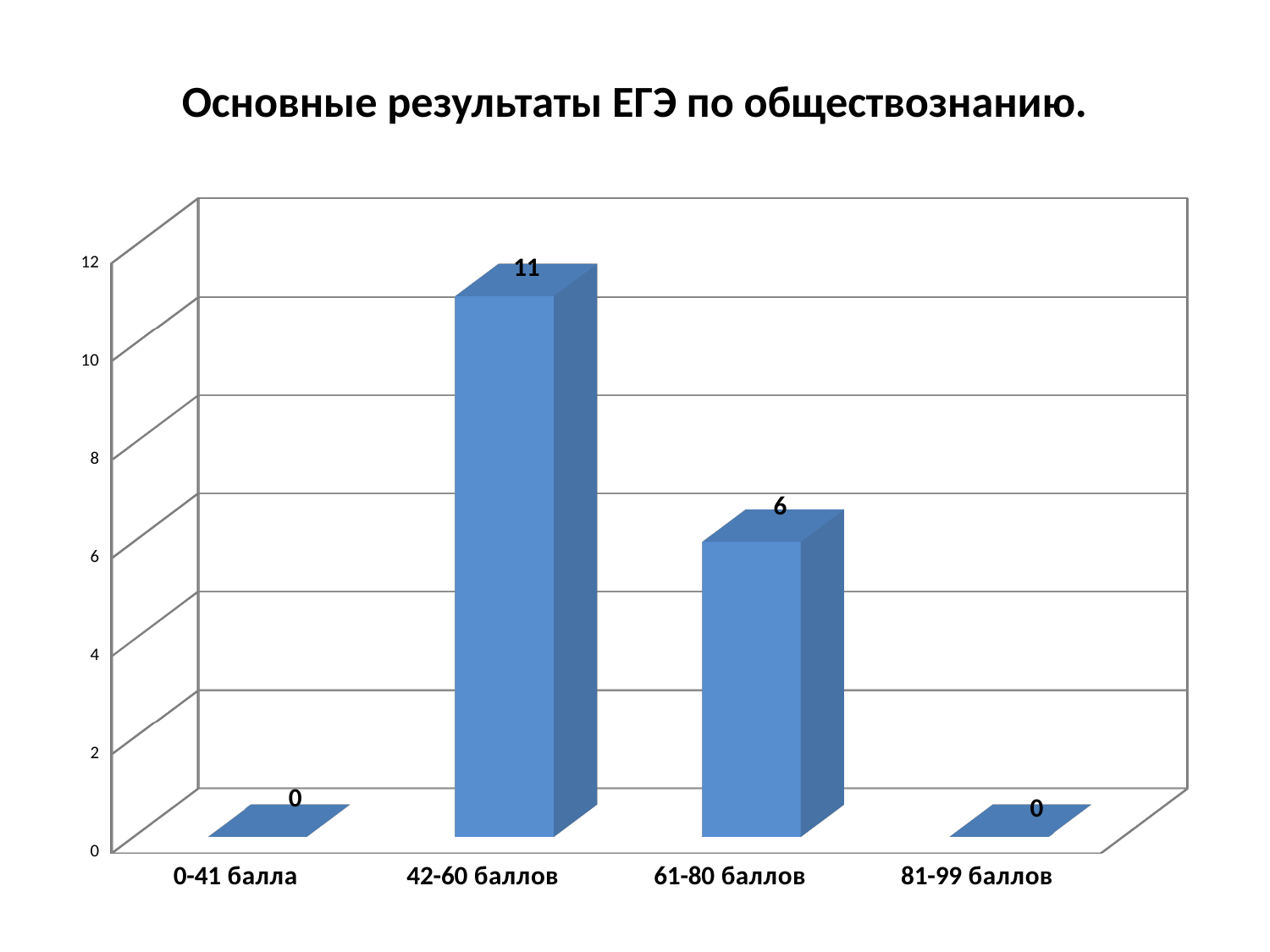
Is the value for 61-80 баллов greater or less than 8? less What is the title of the slide? Основные результаты ЕГЭ по обществознанию. Which is larger, the value for 42-60 баллов or the value for 61-80 баллов? 42-60 баллов How many categories are shown on the x axis? 4 What is the value for the 42-60 баллов category? 11 What is the difference between the values for 42-60 баллов and 61-80 баллов? 5 Which category has the highest value? 42-60 баллов What is the value for the 61-80 баллов category? 6 What kind of chart is shown on the slide? bar chart What is the value for the 0-41 балла category? 0 What is the value for the 81-99 баллов category? 0 Is the value for 42-60 баллов greater or less than 10? greater